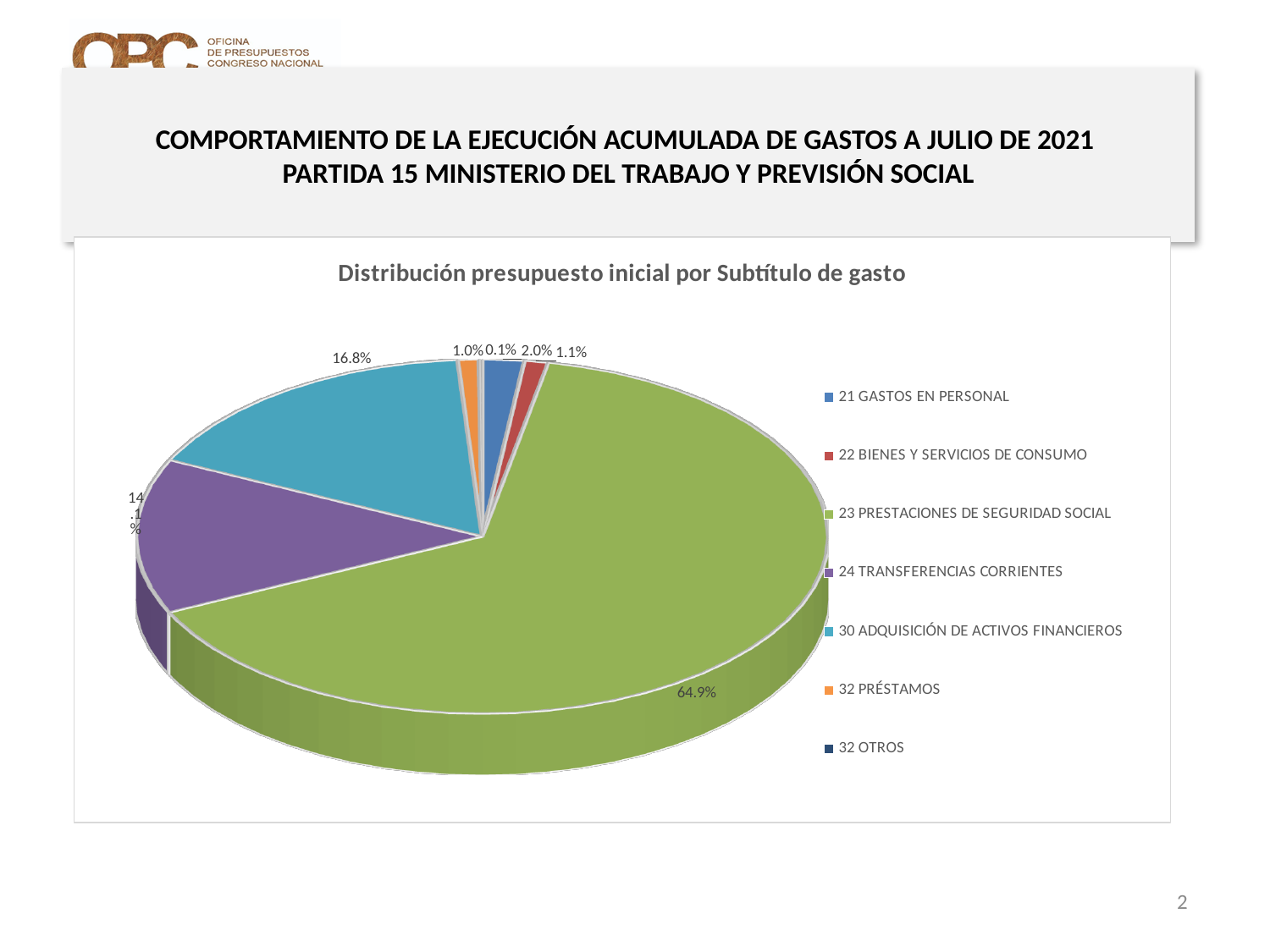
What kind of chart is shown on the slide? Pie chart Which is larger, the slice for 30 ADQUISICIÓN DE ACTIVOS FINANCIEROS or the slice for 24 TRANSFERENCIAS CORRIENTES? 30 ADQUISICIÓN DE ACTIVOS FINANCIEROS What share of the pie does 24 TRANSFERENCIAS CORRIENTES represent? 14.1% What share of the pie does 22 BIENES Y SERVICIOS DE CONSUMO represent? 1.1% What share of the pie does 21 GASTOS EN PERSONAL represent? 2.0% Which category has the smallest slice of the pie? 32 OTROS What is the difference in percentage points between the slices for 30 ADQUISICIÓN DE ACTIVOS FINANCIEROS and 24 TRANSFERENCIAS CORRIENTES? 2.7 What share of the pie does 32 PRÉSTAMOS represent? 1.0% What share of the pie does 23 PRESTACIONES DE SEGURIDAD SOCIAL represent? 64.9% Which category has the largest slice of the pie? 23 PRESTACIONES DE SEGURIDAD SOCIAL How many categories does the legend list? 7 What share of the pie does 30 ADQUISICIÓN DE ACTIVOS FINANCIEROS represent? 16.8%